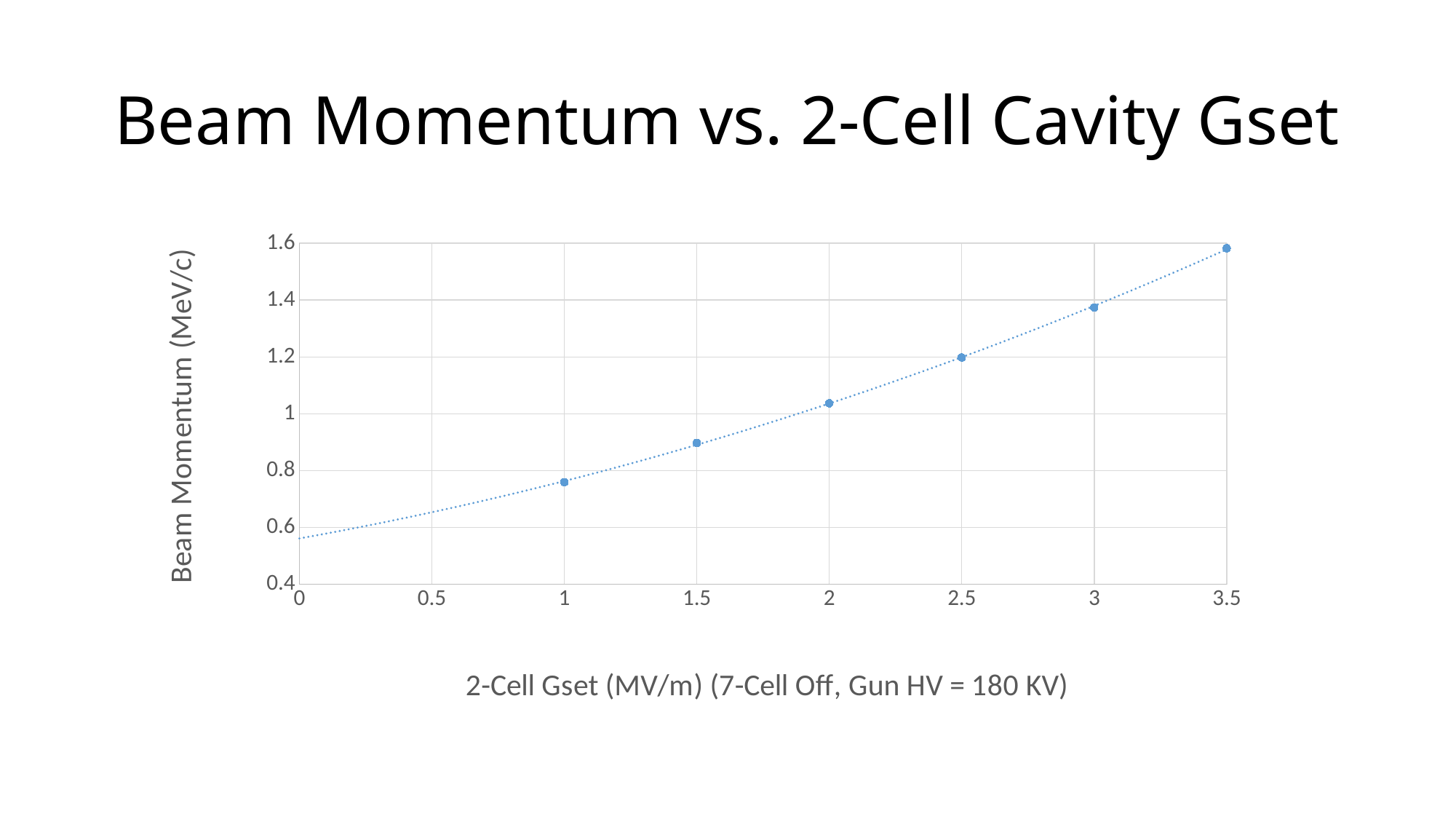
What is the label of the y axis? Beam Momentum (MeV/c) Which has the larger beam momentum: a 2-Cell Gset of 3 or a 2-Cell Gset of 2? 3 Is the beam momentum at a 2-Cell Gset of 3 greater or less than 1.4 MeV/c? less What is the title of the chart? Beam Momentum vs. 2-Cell Cavity Gset Is the beam momentum at a 2-Cell Gset of 2 greater or less than 1 MeV/c? greater How many data points are plotted on the chart? 6 At which 2-Cell Gset value is the beam momentum highest? 3.5 At which 2-Cell Gset value is the beam momentum lowest? 1 What kind of chart is shown on the slide? scatter plot Is the beam momentum at a 2-Cell Gset of 1 greater or less than 0.8 MeV/c? less Does beam momentum rise or fall as the 2-Cell Gset increases along the x axis? rise